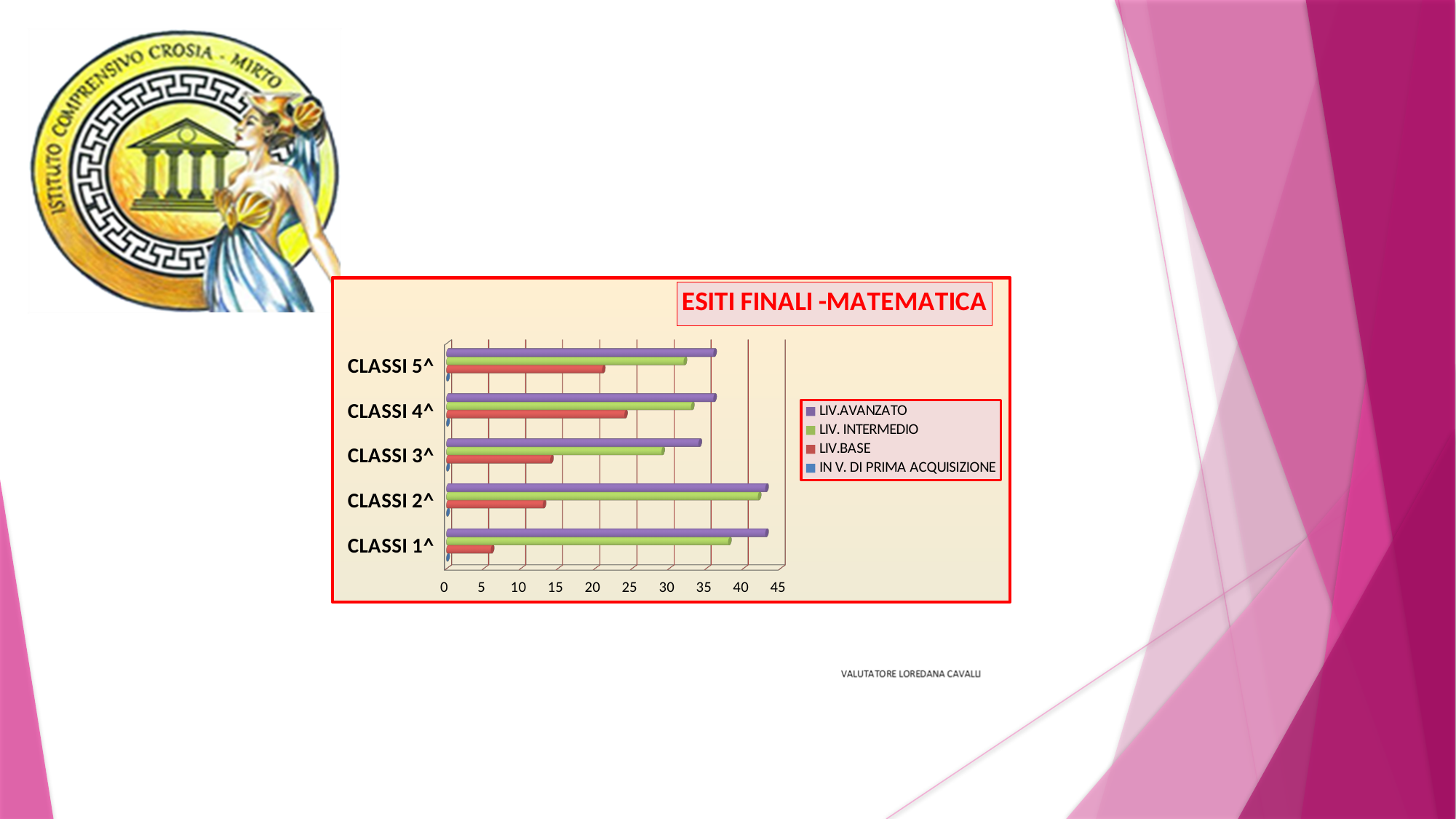
How many series does the chart legend list? 4 What is the title of the chart? ESITI FINALI -MATEMATICA Which series is shown in green in the chart? LIV. INTERMEDIO Is the LIV.AVANZATO value for CLASSI 2^ greater or less than 40? greater Which is larger for CLASSI 3^: the LIV.AVANZATO value or the LIV.BASE value? LIV.AVANZATO Is the LIV. INTERMEDIO value for CLASSI 5^ greater or less than 30? greater Which is larger: the LIV.BASE value for CLASSI 4^ or for CLASSI 1^? CLASSI 4^ How many class categories are shown on the chart? 5 Is the LIV.BASE value for CLASSI 3^ greater or less than 20? less What kind of chart is shown on the slide? bar chart Which class has the lowest LIV.BASE value? CLASSI 1^